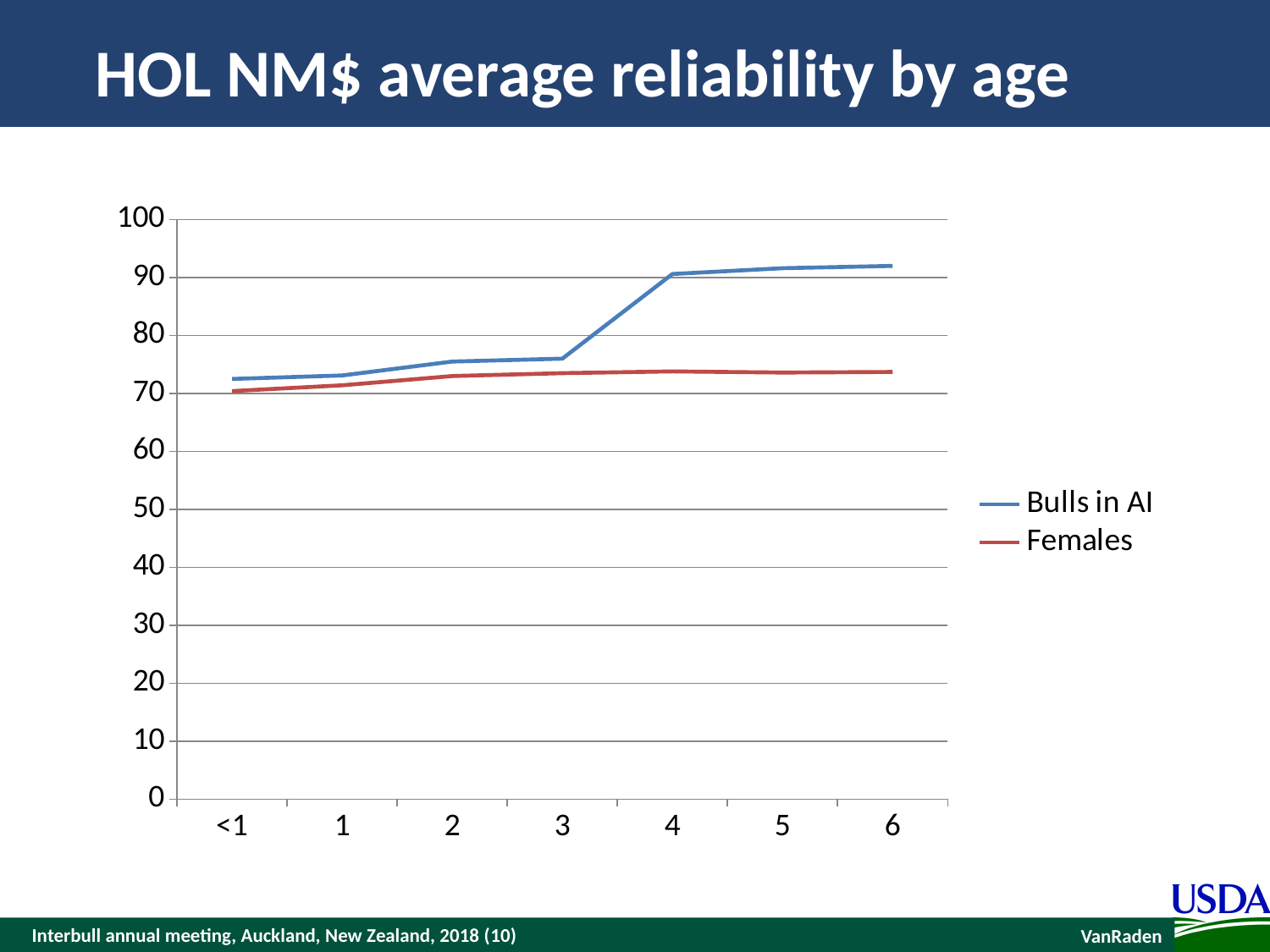
What is the title of the chart? HOL NM$ average reliability by age Is the value for Bulls in AI at age 3 greater or less than 80? less Is the value for Females at age 6 greater or less than 70? greater Is the value for Bulls in AI at age 6 greater or less than 90? greater Do the values for Bulls in AI rise or fall from age <1 to age 6? rise What kind of chart is shown on the slide? line chart How many series does the legend list? 2 For Bulls in AI, is the value at age 4 larger or smaller than the value at age 3? larger Which series has the higher value at age 4, Bulls in AI or Females? Bulls in AI How many age categories are shown on the x axis? 7 What colour is the line for Bulls in AI? blue